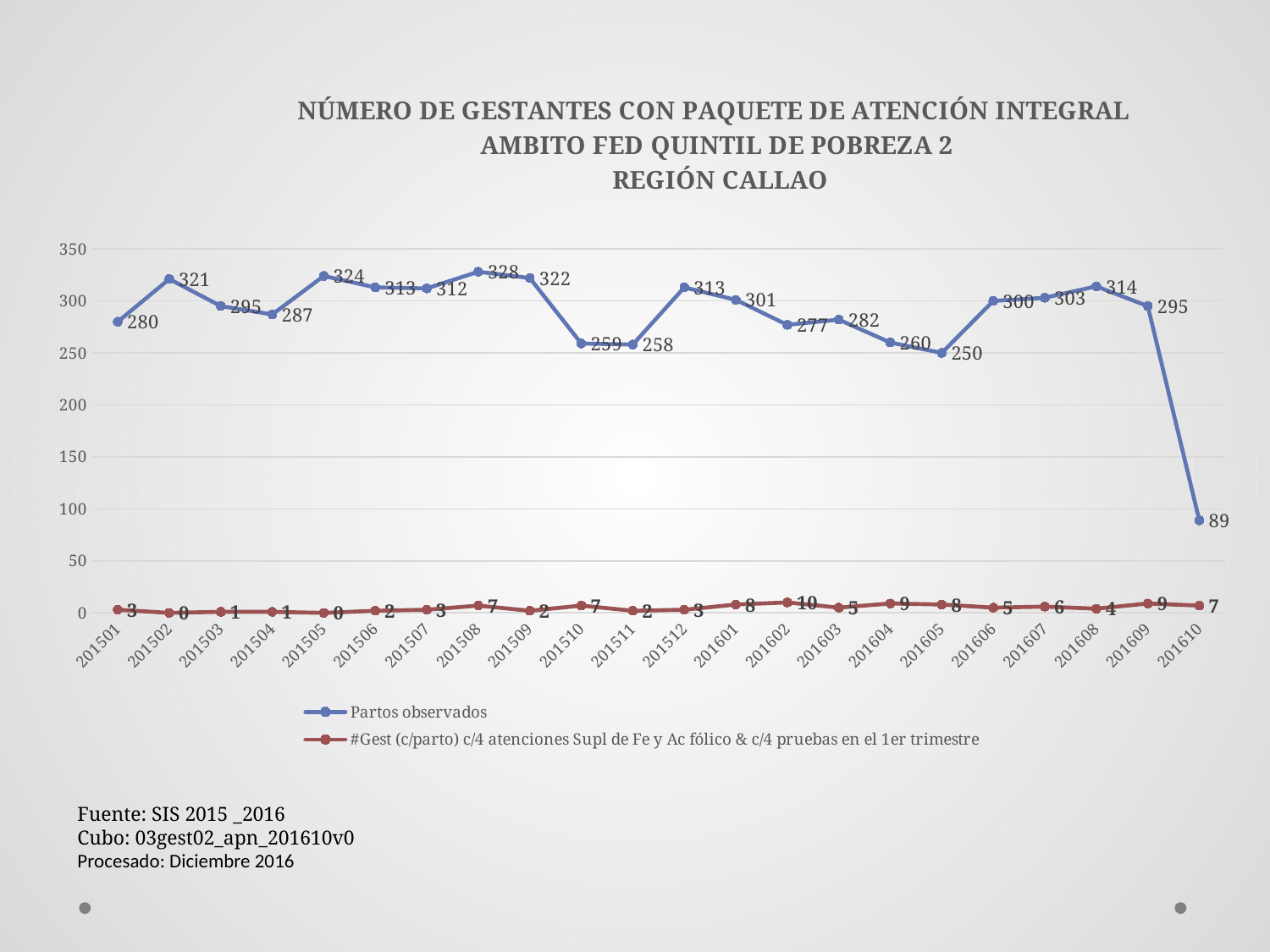
What is the value of Partos observados for 201610? 89 How many months (data points) are plotted along the x axis? 22 In which month does Partos observados reach its highest value? 201508 How many series does the legend list? 2 Which is larger, Partos observados in 201502 or in 201505? 201505 What is the difference between Partos observados in 201609 and 201610? 206 What is the region named in the chart title? REGIÓN CALLAO What is the value of the #Gest (c/parto) series for 201602? 10 Is the value of Partos observados for 201605 greater or less than 300? less In which month does Partos observados reach its lowest value? 201610 What type of chart is shown on the slide? Line chart What is the value of Partos observados for 201508? 328